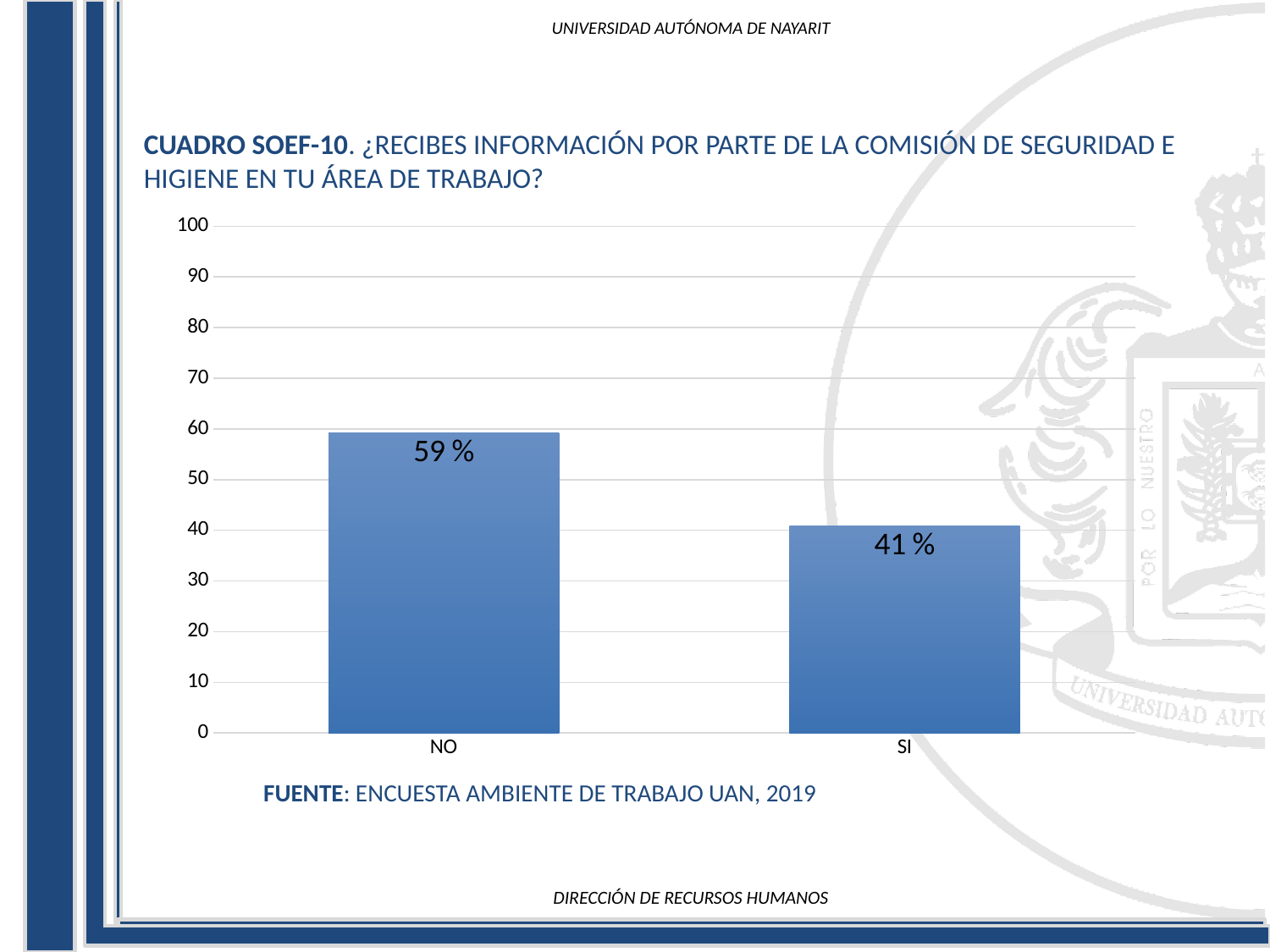
How many categories are shown on the x axis? 2 What is the value for NO? 59 % Which category has the lowest value? SI Is the value for SI greater or less than 50? less What is the maximum value shown on the y axis? 100 What kind of chart is shown on the slide? bar chart Which is larger, the value for NO or the value for SI? NO Which category has the highest value? NO What source is cited below the chart? ENCUESTA AMBIENTE DE TRABAJO UAN, 2019 Is the value for NO greater or less than 50? greater What is the value for SI? 41 % What is the difference between the values for NO and SI? 18 %